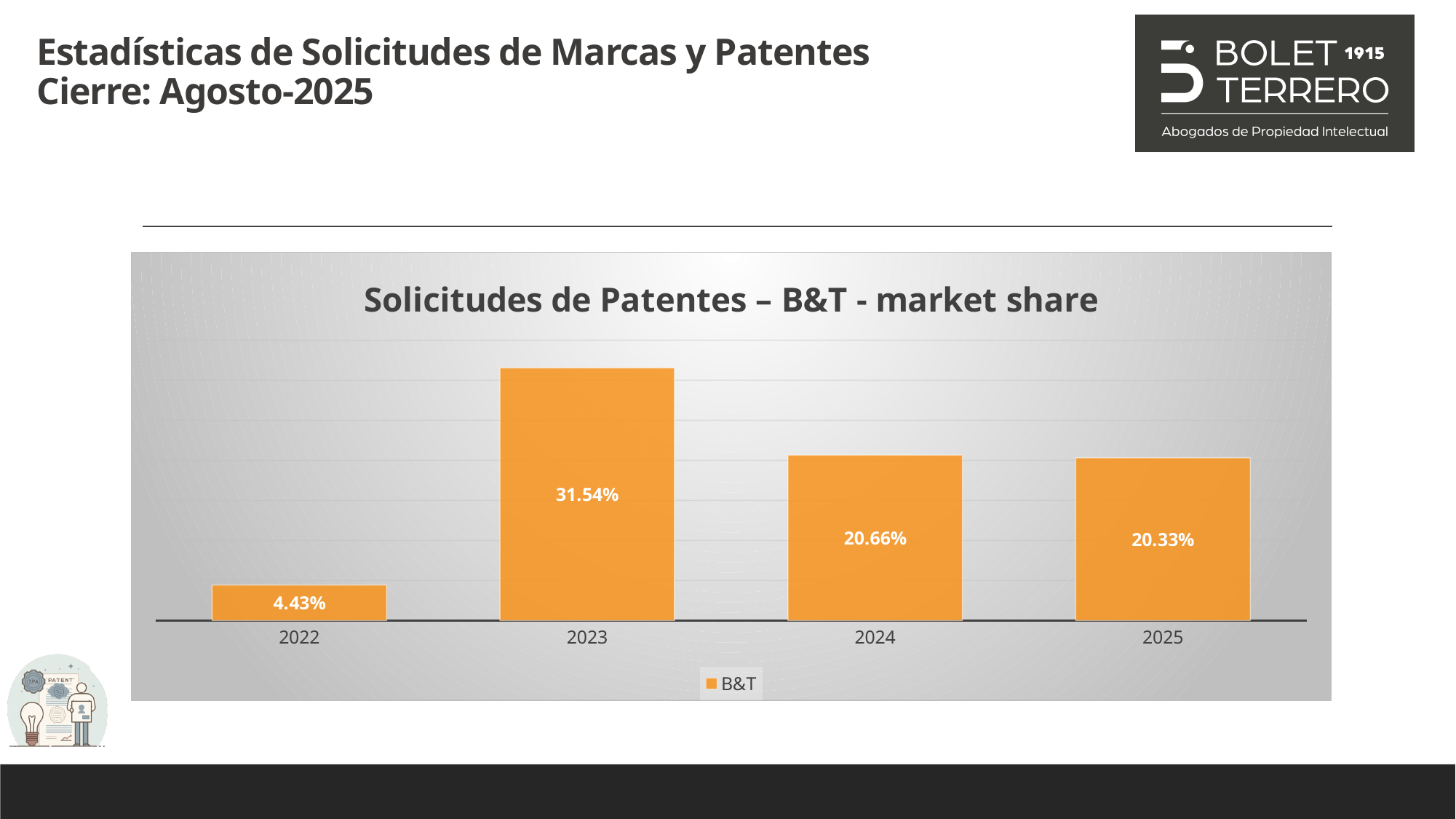
What is the title of the chart? Solicitudes de Patentes – B&T - market share How many series does the legend list? 1 How many years are shown on the x axis of the chart? 4 What is the difference between the 2024 and 2022 values? 16.23% Which year has the lowest B&T market share? 2022 Which year has the highest B&T market share? 2023 What is the B&T market share value for 2022? 4.43% What is the B&T market share value for 2023? 31.54% What kind of chart is shown on the slide? Bar chart What is the difference between the 2023 and 2024 values? 10.88% Which is larger, the value for 2023 or the value for 2025? 2023 What is the B&T market share value for 2025? 20.33%